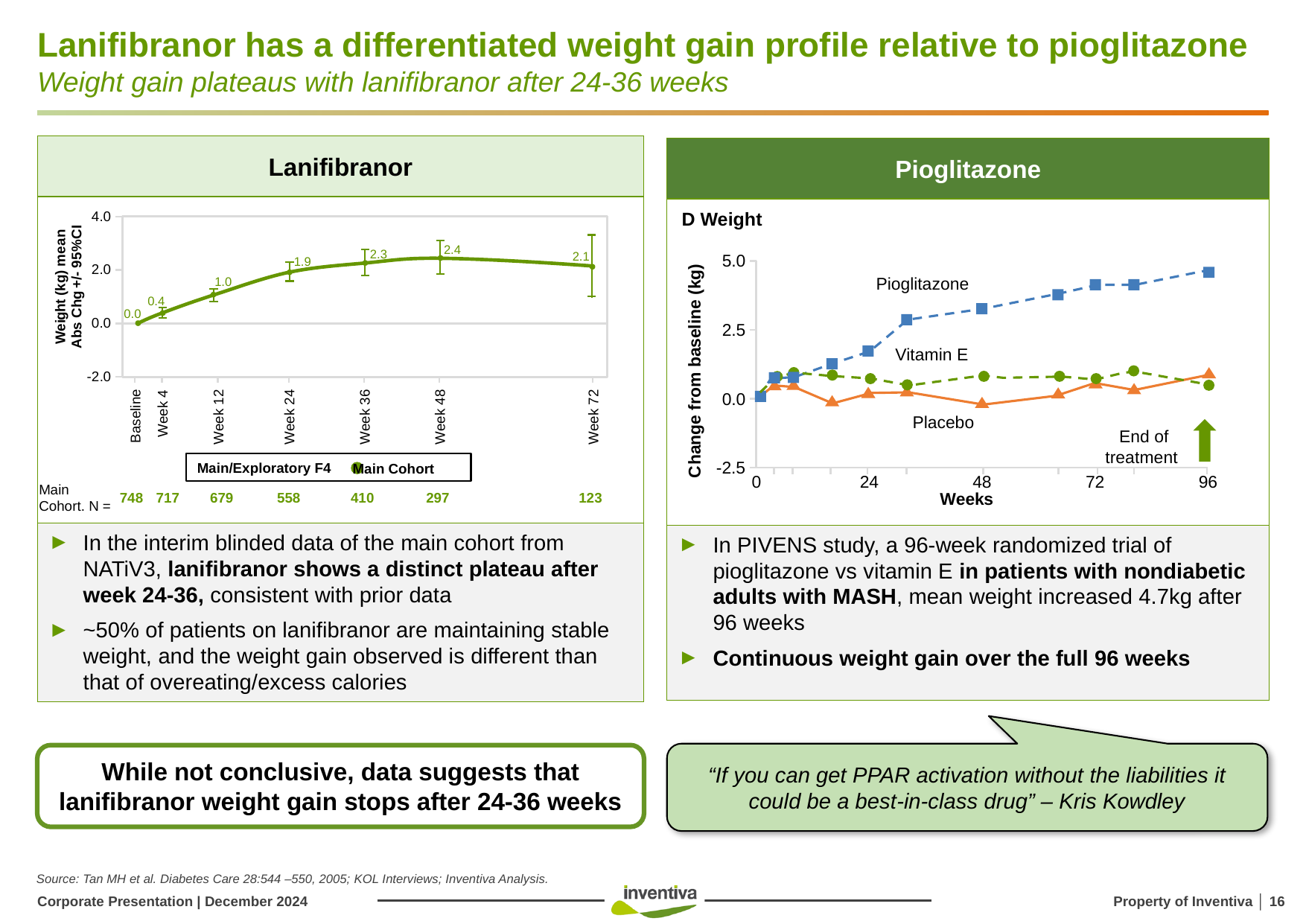
In the Lanifibranor chart, what is the mean weight change at Week 12? 1.0 In the Lanifibranor chart, does the mean weight change rise or fall from Baseline to Week 24? rise In the Lanifibranor chart, what is the Main Cohort N at Week 24? 558 In the Lanifibranor chart, what is the difference between the mean weight change at Week 48 and at Week 24? 0.5 In the Pioglitazone chart, is the change from baseline for Pioglitazone at week 96 greater or less than 2.5? greater In the Lanifibranor chart, what is the mean weight change at Week 48? 2.4 In the Pioglitazone chart, which series has the highest change from baseline at week 96? Pioglitazone In the Lanifibranor chart, is the mean weight change larger at Week 36 or at Week 72? Week 36 In the Pioglitazone chart, how many series are plotted? 3 In the Lanifibranor chart, at which time point is the mean weight change highest? Week 48 What type of chart is the Pioglitazone chart? line chart In the Lanifibranor chart, how many time points are plotted on the x axis? 7